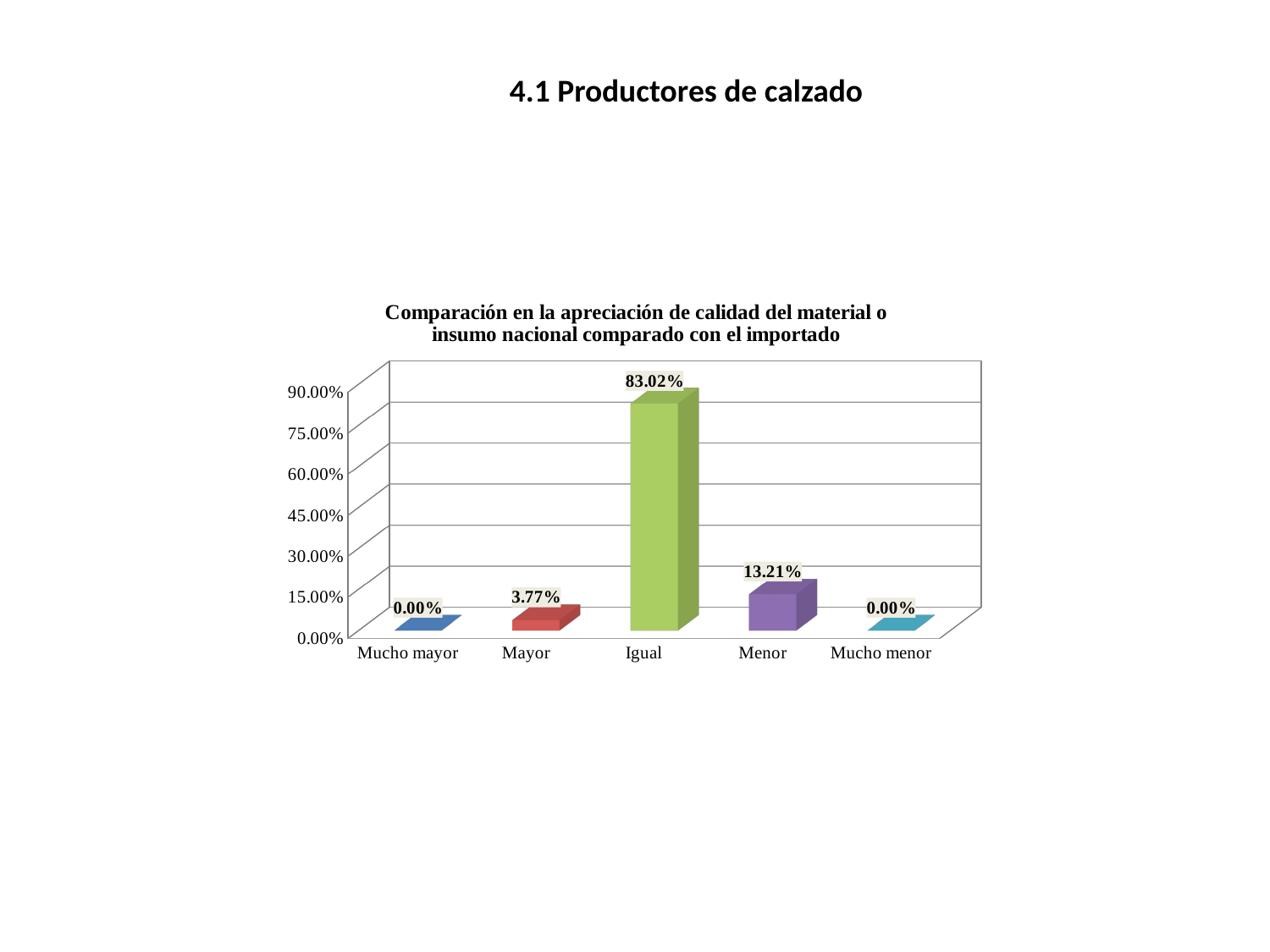
What kind of chart is shown on the slide? bar chart What is the difference between the values for Menor and Mayor? 9.44% Which category has the highest value? Igual How many categories are shown on the x axis? 5 What is the value for Mayor? 3.77% What is the value for Igual? 83.02% What is the value for Mucho mayor? 0.00% What is the title of the chart? Comparación en la apreciación de calidad del material o insumo nacional comparado con el importado What is the value for Menor? 13.21% Is the value for Igual greater or less than 75.00%? greater What is the difference between the values for Igual and Menor? 69.81% Which is larger, the value for Mayor or the value for Menor? Menor